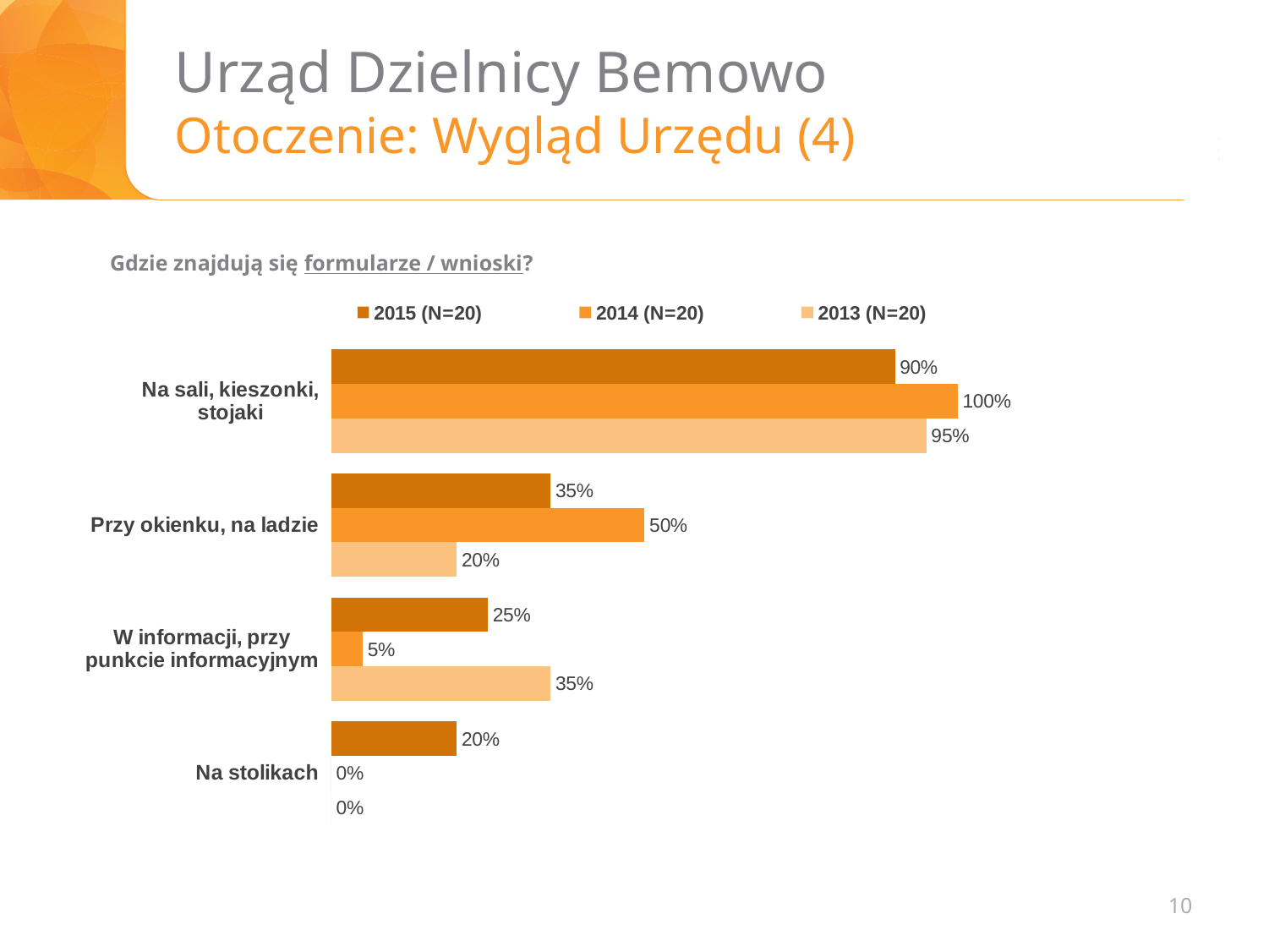
Which category has the highest value in the 2015 (N=20) series? Na sali, kieszonki, stojaki What is the value for "Na stolikach" in the 2014 (N=20) series? 0% For "W informacji, przy punkcie informacyjnym", which series has the larger value: 2015 (N=20) or 2014 (N=20)? 2015 (N=20) What is the difference between the 2014 (N=20) and 2013 (N=20) values for "Przy okienku, na ladzie"? 30% Which category has the lowest value in the 2014 (N=20) series? Na stolikach What is the value for "W informacji, przy punkcie informacyjnym" in the 2015 (N=20) series? 25% What kind of chart is shown on the slide? Bar chart What question does the chart answer, as stated above it? Gdzie znajdują się formularze / wnioski? How many series does the legend list? 3 What is the value for "Na sali, kieszonki, stojaki" in the 2014 (N=20) series? 100% How many categories are shown on the chart? 4 What is the value for "Przy okienku, na ladzie" in the 2013 (N=20) series? 20%